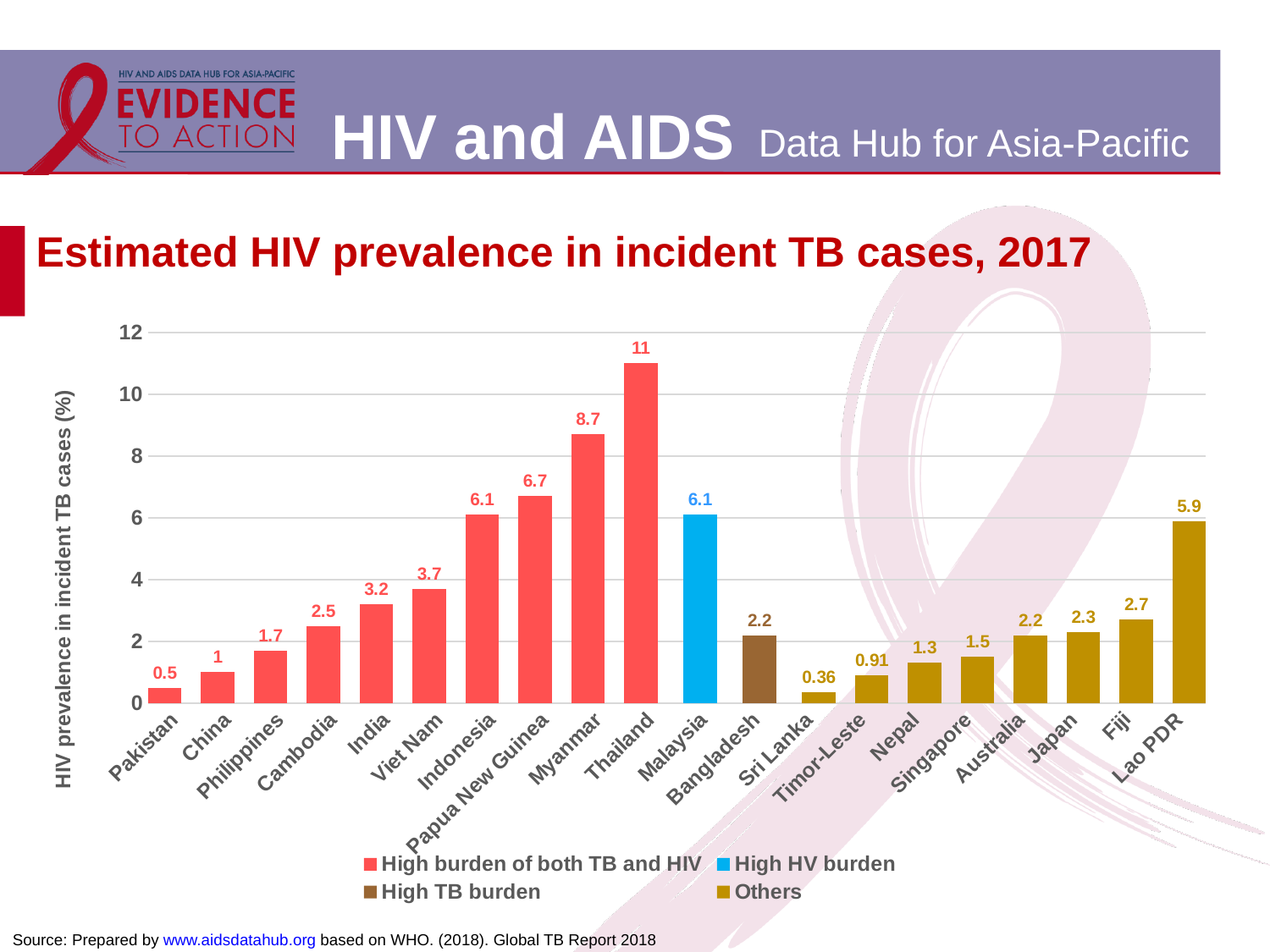
Which is larger, the value for Papua New Guinea or the value for Malaysia? Papua New Guinea Which legend category does Malaysia belong to? High HV burden What is the value for Timor-Leste? 0.91 What is the difference between the values for Thailand and Myanmar? 2.3 What is the value for Lao PDR? 5.9 How many countries are shown on the x axis? 20 What kind of chart is shown on the slide? Bar chart What is the value for Sri Lanka? 0.36 What is the value for Thailand? 11 Which country has the lowest HIV prevalence in incident TB cases? Sri Lanka How many series does the legend list? 4 Which country has the highest HIV prevalence in incident TB cases? Thailand